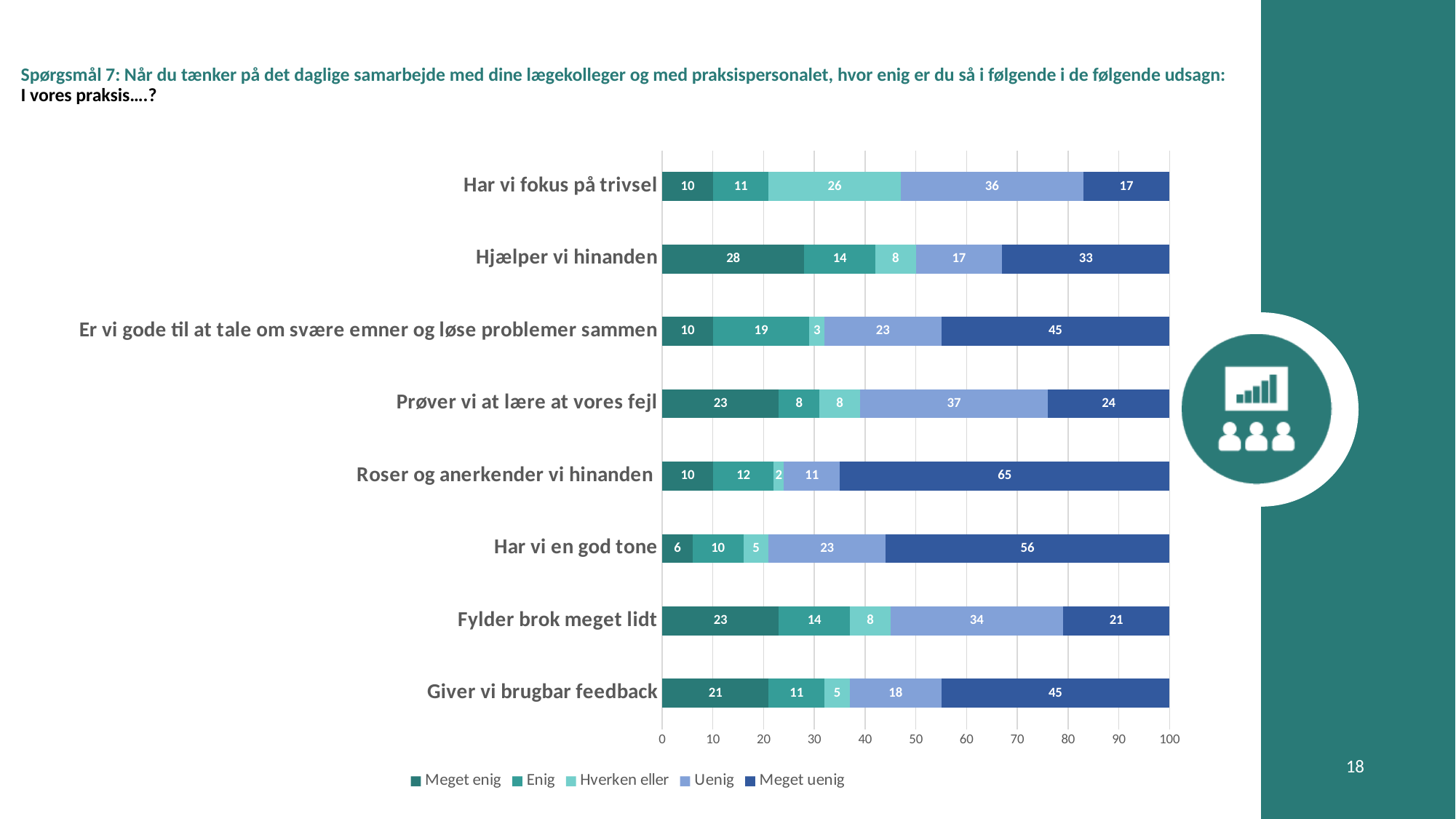
What is the 'Meget uenig' value for 'Roser og anerkender vi hinanden'? 65 Which is larger: the 'Enig' value for 'Er vi gode til at tale om svære emner og løse problemer sammen' or the 'Enig' value for 'Fylder brok meget lidt'? Er vi gode til at tale om svære emner og løse problemer sammen How many series does the legend list? 5 Which statement has the lowest 'Meget enig' value? Har vi en god tone What is the difference between the 'Uenig' values for 'Prøver vi at lære at vores fejl' and 'Giver vi brugbar feedback'? 19 What is the 'Meget enig' value for 'Hjælper vi hinanden'? 28 Which legend entry is shown in the darkest blue colour? Meget uenig What is the 'Hverken eller' value for 'Har vi fokus på trivsel'? 26 Which statement has the highest 'Meget uenig' value? Roser og anerkender vi hinanden What type of chart is shown on the slide? Stacked bar chart How many categories (statements) are plotted on the chart? 8 What is the total of the stacked bar for 'Har vi en god tone'? 100